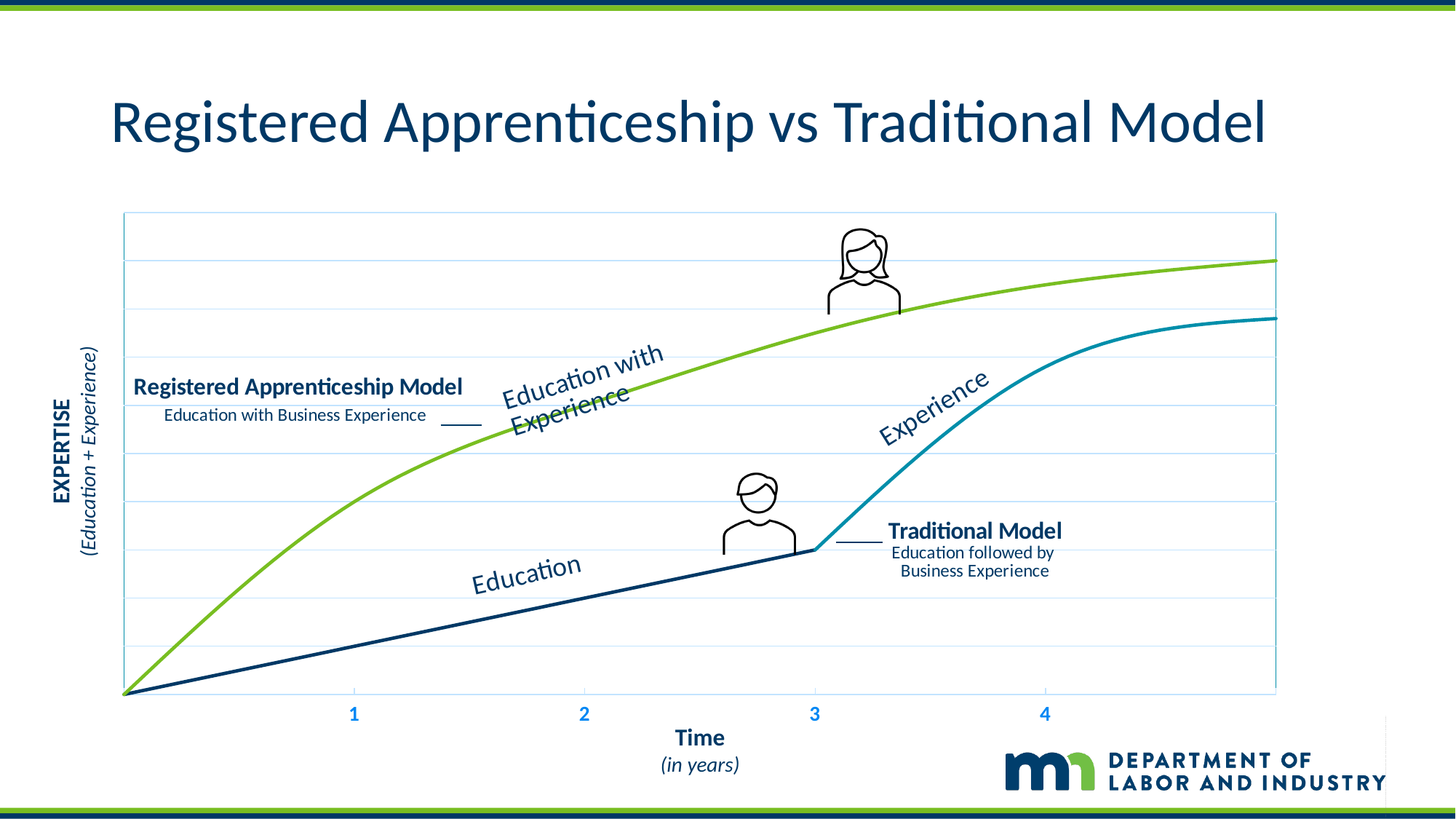
Does the Traditional Model line rise more steeply before year 3 or after year 3? after year 3 What kind of chart is shown on the slide? line chart How many models (series) are plotted on the chart? 2 At the right end of the chart, which model's line is lower? Traditional Model What is the label of the horizontal axis? Time (in years) At year 4, which model shows higher expertise? Registered Apprenticeship Model What label is written along the green curve? Education with Experience At year 2, which model shows higher expertise? Registered Apprenticeship Model How many numbered tick marks are shown on the Time axis? 4 Does the Registered Apprenticeship Model line rise or fall as time increases? rise At which year does the Traditional Model line change from the Education phase to the Experience phase? 3 Does the Traditional Model line rise or fall as time increases? rise